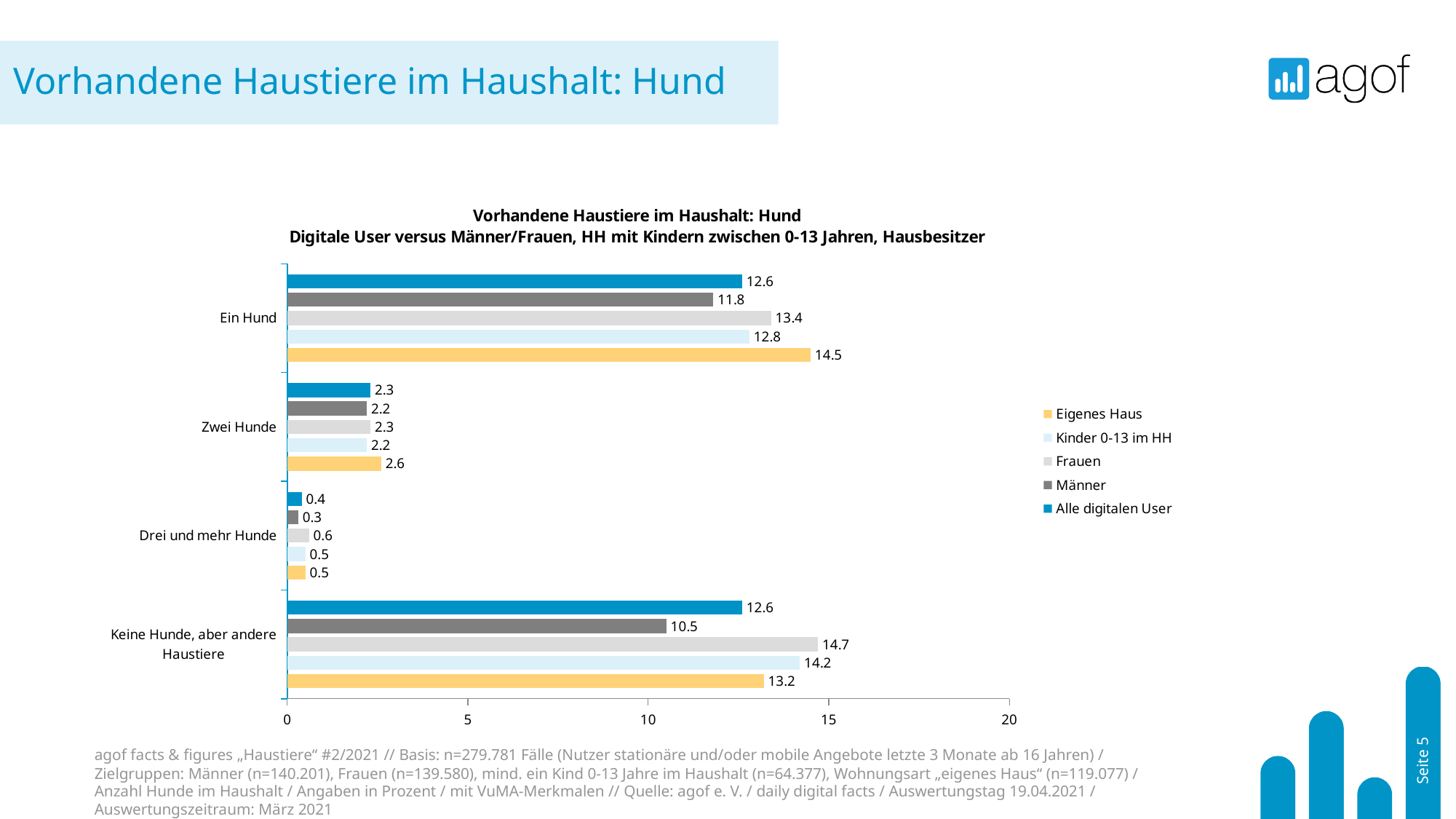
Is the value for Kinder 0-13 im HH in the category Keine Hunde, aber andere Haustiere greater or less than 10? greater Which series has the lowest value in the category Ein Hund? Männer Which legend entry is shown in yellow? Eigenes Haus What is the value for Männer in the category Keine Hunde, aber andere Haustiere? 10.5 What is the value for Eigenes Haus in the category Ein Hund? 14.5 In the category Zwei Hunde, which is larger: the value for Eigenes Haus or the value for Alle digitalen User? Eigenes Haus Which series has the highest value in the category Keine Hunde, aber andere Haustiere? Frauen How many categories are shown on the chart? 4 How many series does the legend list? 5 What is the value for Frauen in the category Drei und mehr Hunde? 0.6 What is the difference between the Frauen and Männer values in the category Ein Hund? 1.6 What kind of chart is shown on the slide? bar chart